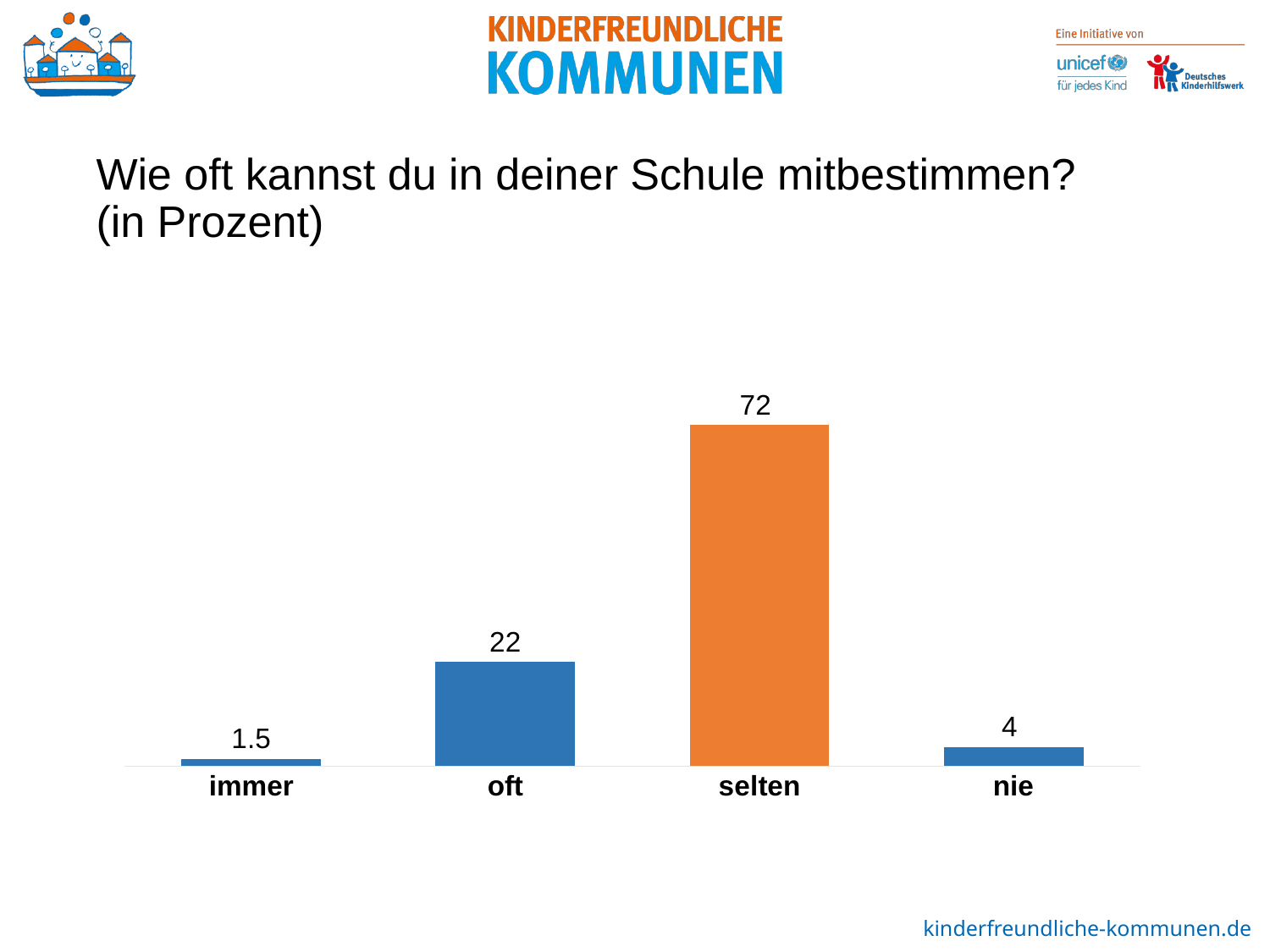
What is the value for "oft"? 22 What is the value for "nie"? 4 What kind of chart is shown on the slide? bar chart Which is larger, the value for "oft" or the value for "nie"? oft Which bar is coloured orange rather than blue? selten What is the difference between the values for "nie" and "immer"? 2.5 What is the difference between the values for "selten" and "oft"? 50 How many categories are shown on the x axis? 4 Which category has the lowest value? immer Which category has the highest value? selten What is the value for "immer"? 1.5 What is the value for "selten"? 72